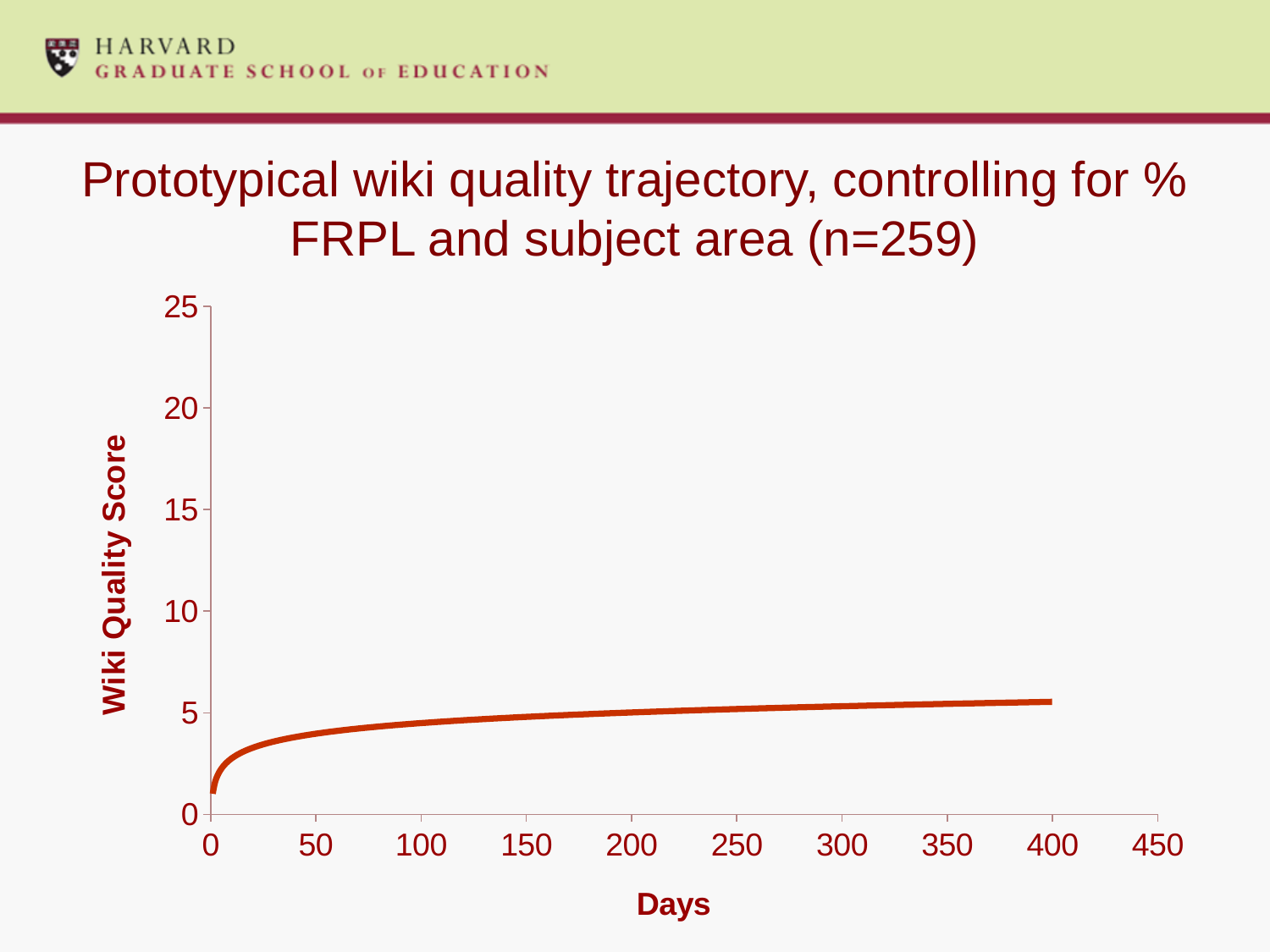
Is the Wiki Quality Score at 200 days greater or less than 15? less Is the Wiki Quality Score at 400 days greater or less than 10? less Is the Wiki Quality Score at 100 days greater or less than 20? less How many lines are plotted on the chart? 1 What is the label of the y axis? Wiki Quality Score What is the label of the x axis? Days What kind of chart is shown on the slide? line chart Does the Wiki Quality Score rise or fall as Days increase? rise What is the highest value shown on the y axis? 25 What is the highest value shown on the x axis? 450